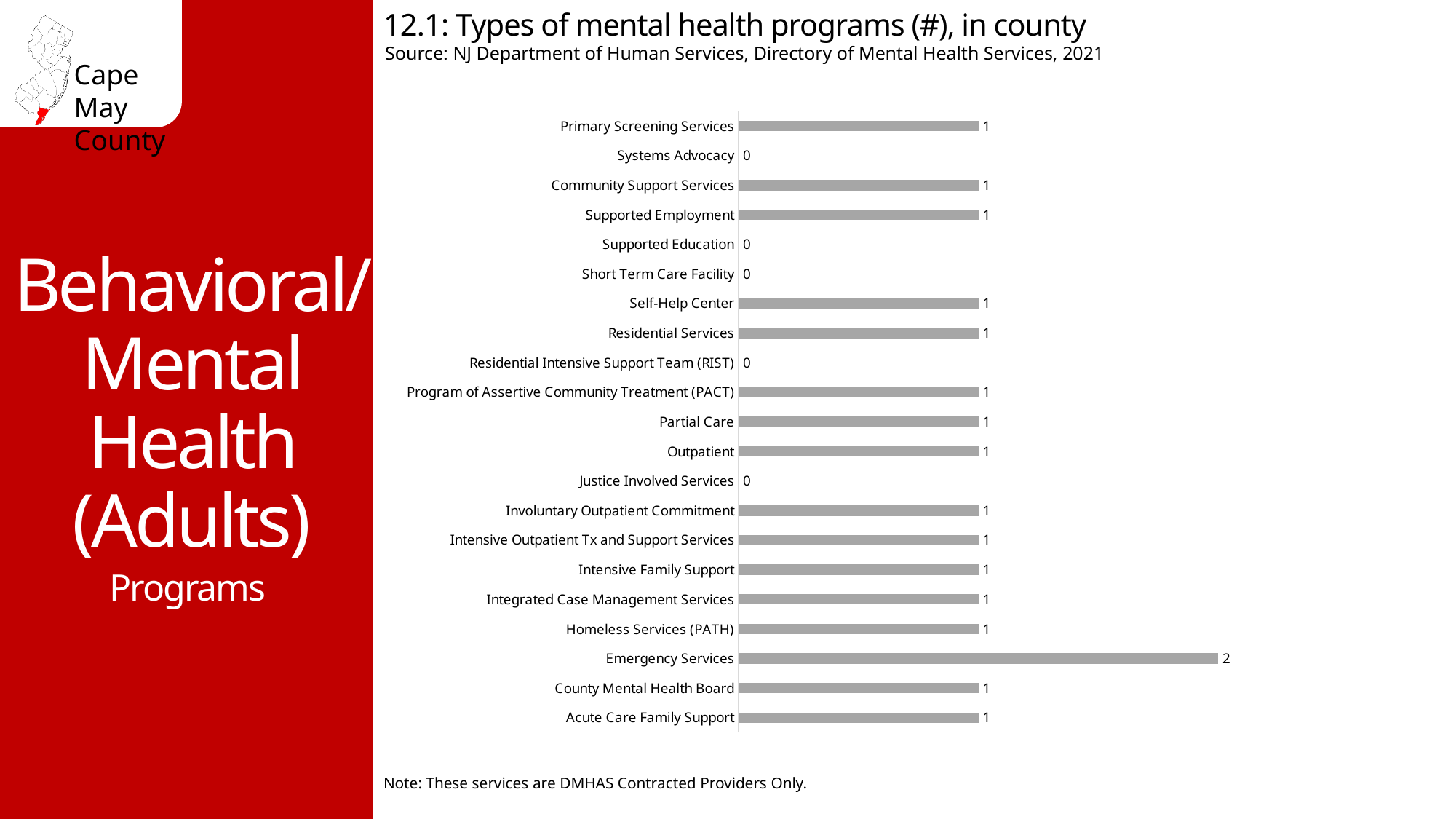
What is the title of the chart? 12.1: Types of mental health programs (#), in county Which is larger, the value for Supported Employment or the value for Supported Education? Supported Employment Which category has the highest value? Emergency Services How many categories have a value of 0? 5 What kind of chart is shown on the slide? Bar chart What is the value for Residential Intensive Support Team (RIST)? 0 What is the source of the chart data? NJ Department of Human Services, Directory of Mental Health Services, 2021 What is the value for Outpatient? 1 What is the difference between the values for Emergency Services and Homeless Services (PATH)? 1 What is the value for Emergency Services? 2 How many categories are shown in the chart? 21 What is the value for Systems Advocacy? 0